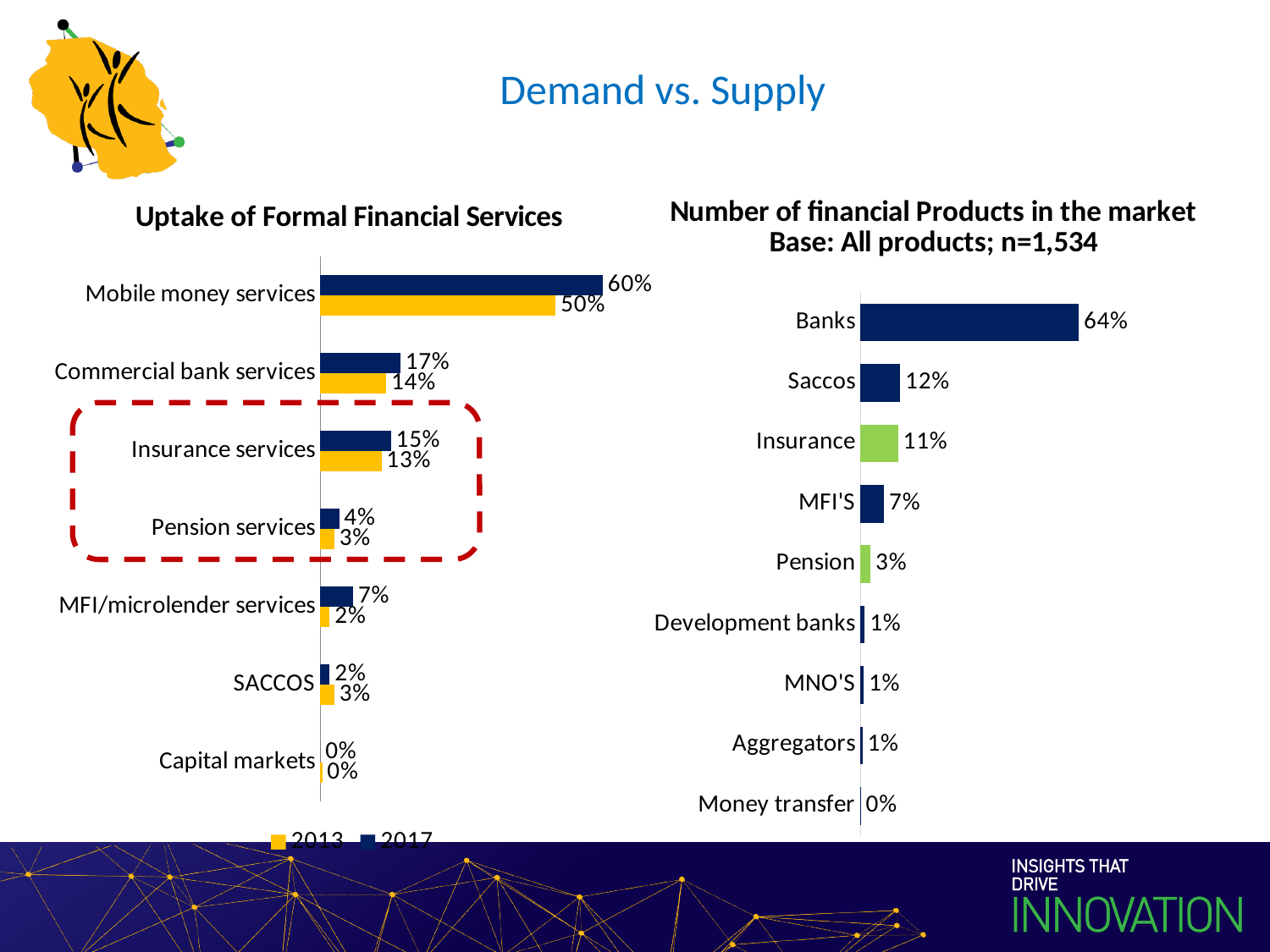
In the 'Uptake of Formal Financial Services' chart, what is the 2017 value for Mobile money services? 60% In the 'Number of financial Products in the market' chart, which category has the lowest value? Money transfer In the 'Uptake of Formal Financial Services' chart, what is the 2013 value for Insurance services? 13% In the 'Number of financial Products in the market' chart, what is the value for MFI'S? 7% How many series does the legend of the 'Uptake of Formal Financial Services' chart list? 2 How many categories are shown in the 'Uptake of Formal Financial Services' chart? 7 In the 'Uptake of Formal Financial Services' chart, which is larger for SACCOS: the 2013 value or the 2017 value? 2013 In the 'Number of financial Products in the market' chart, what is the value for Banks? 64% In the 'Uptake of Formal Financial Services' chart, what is the difference between the 2017 and 2013 values for Mobile money services? 10% What type of chart is the 'Number of financial Products in the market' chart? Bar chart How many categories are shown in the 'Number of financial Products in the market' chart? 9 In the 'Uptake of Formal Financial Services' chart, which category has the highest 2017 value? Mobile money services